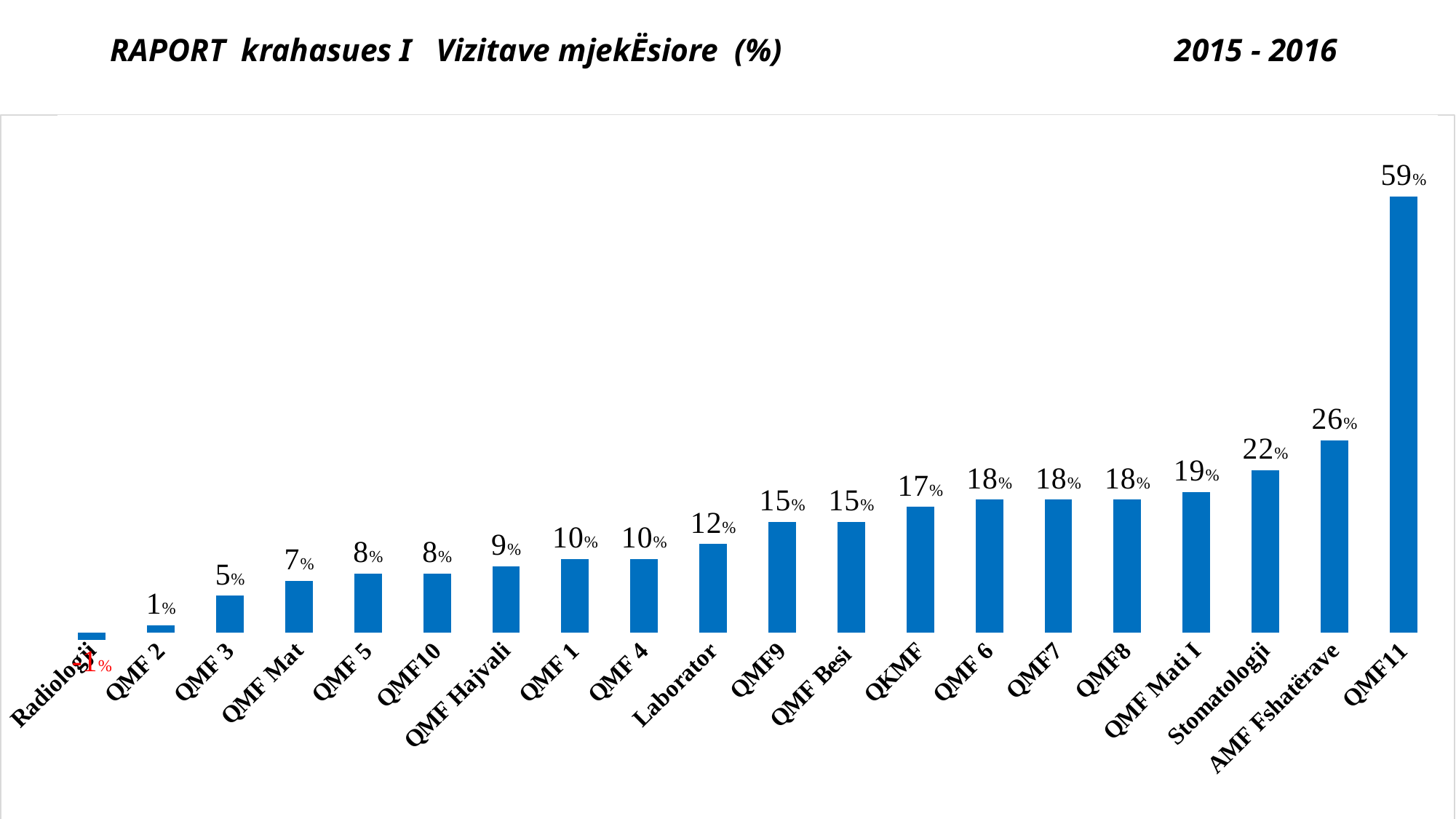
What is the value for AMF Fshatërave? 26% What kind of chart is shown on the slide? Bar chart What is the value for Stomatologji? 22% What is the difference between the values for QMF11 and AMF Fshatërave? 33% What is the value for QMF Hajvali? 9% What is the value for QMF11? 59% Which category has the highest value? QMF11 What is the value for Laborator? 12% Which is larger, the value for QKMF or the value for Laborator? QKMF Do the values generally rise or fall from left to right along the x axis? Rise What is the difference between the values for QMF Mati I and QMF 3? 14% How many categories are shown on the x axis? 20